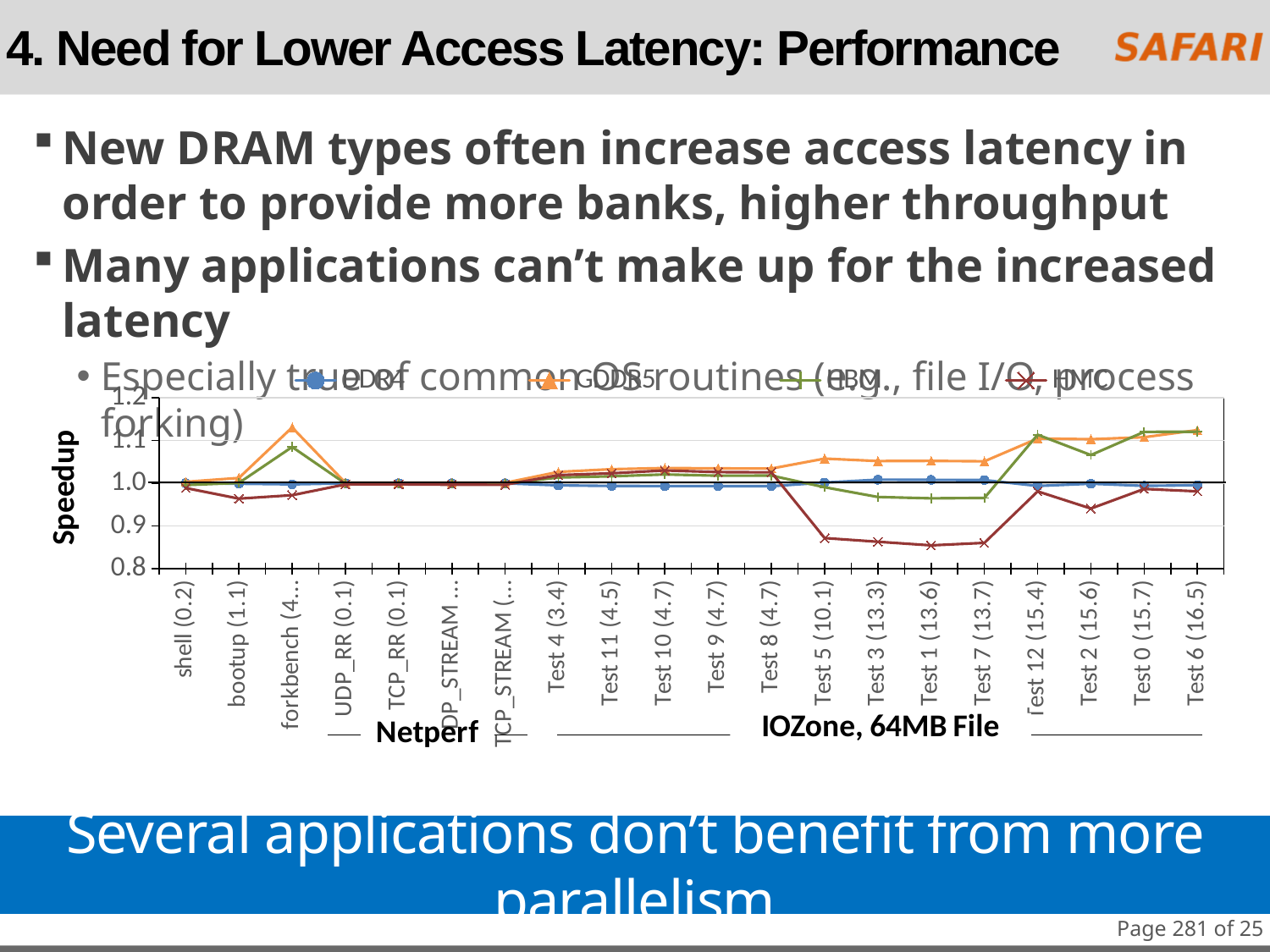
Is the HBM speedup for Test 3 (13.3) greater or less than 1.0? less For forkbench, which series has the higher speedup, GDDR5 or HBM? GDDR5 Is the GDDR5 speedup for forkbench greater or less than 1.1? greater Is the HBM speedup for Test 6 (16.5) greater or less than 1.1? greater How many categories are plotted along the x axis of the chart? 20 Which two benchmark groups are labelled beneath the x axis of the chart? Netperf and IOZone, 64MB File What is the label of the y axis of the chart? Speedup What kind of chart is shown on the slide? line chart How many series does the chart's legend list? 4